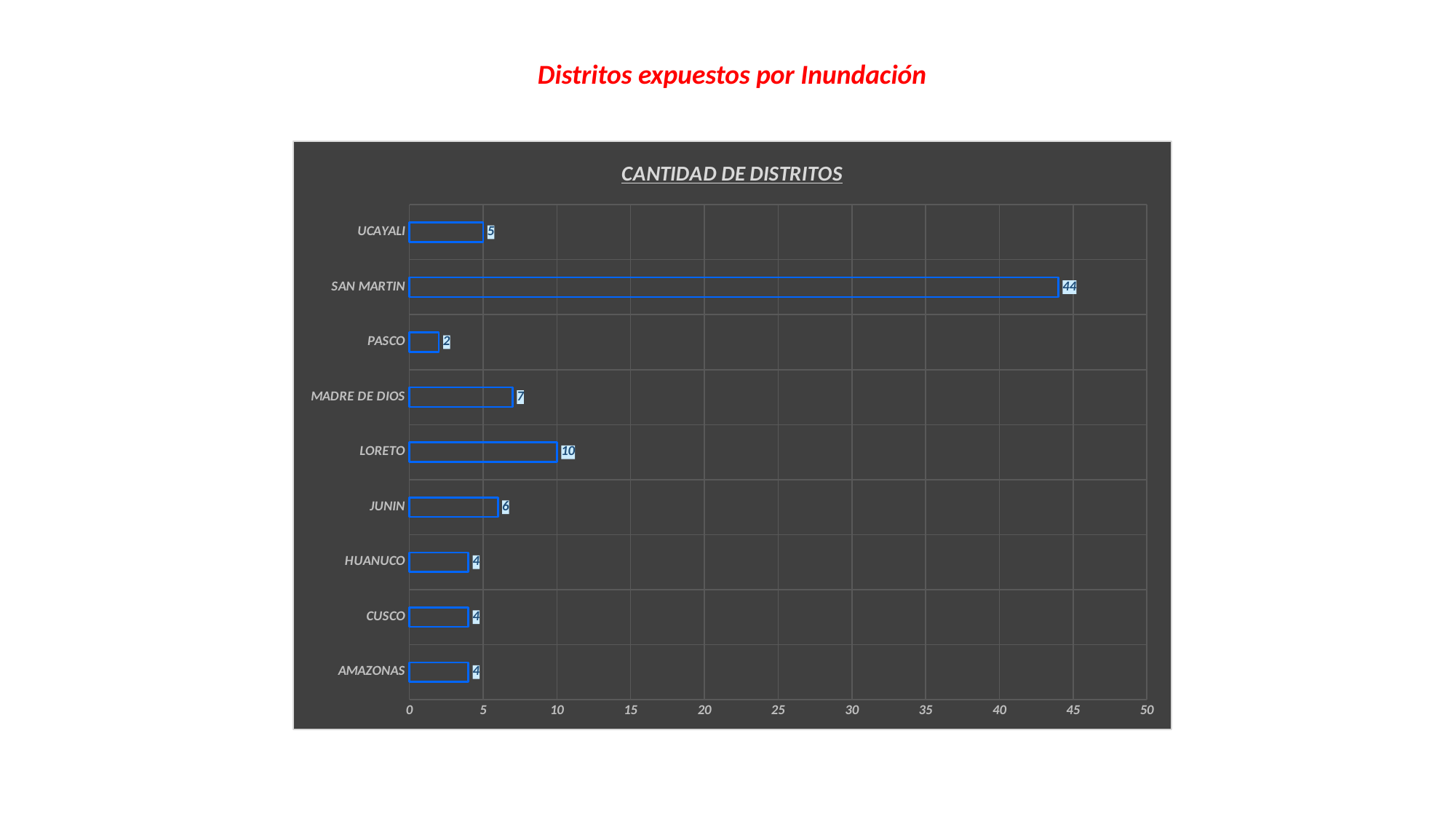
How many categories are shown in the chart? 9 Is the value for SAN MARTIN greater or less than 40? greater Which category has the highest value? SAN MARTIN What is the value for LORETO? 10 What is the title of the chart? CANTIDAD DE DISTRITOS What kind of chart is shown? bar chart What is the difference between the values for SAN MARTIN and LORETO? 34 What is the value for SAN MARTIN? 44 What is the value for PASCO? 2 Which category has the lowest value? PASCO Which is larger, the value for JUNIN or the value for UCAYALI? JUNIN What is the value for MADRE DE DIOS? 7